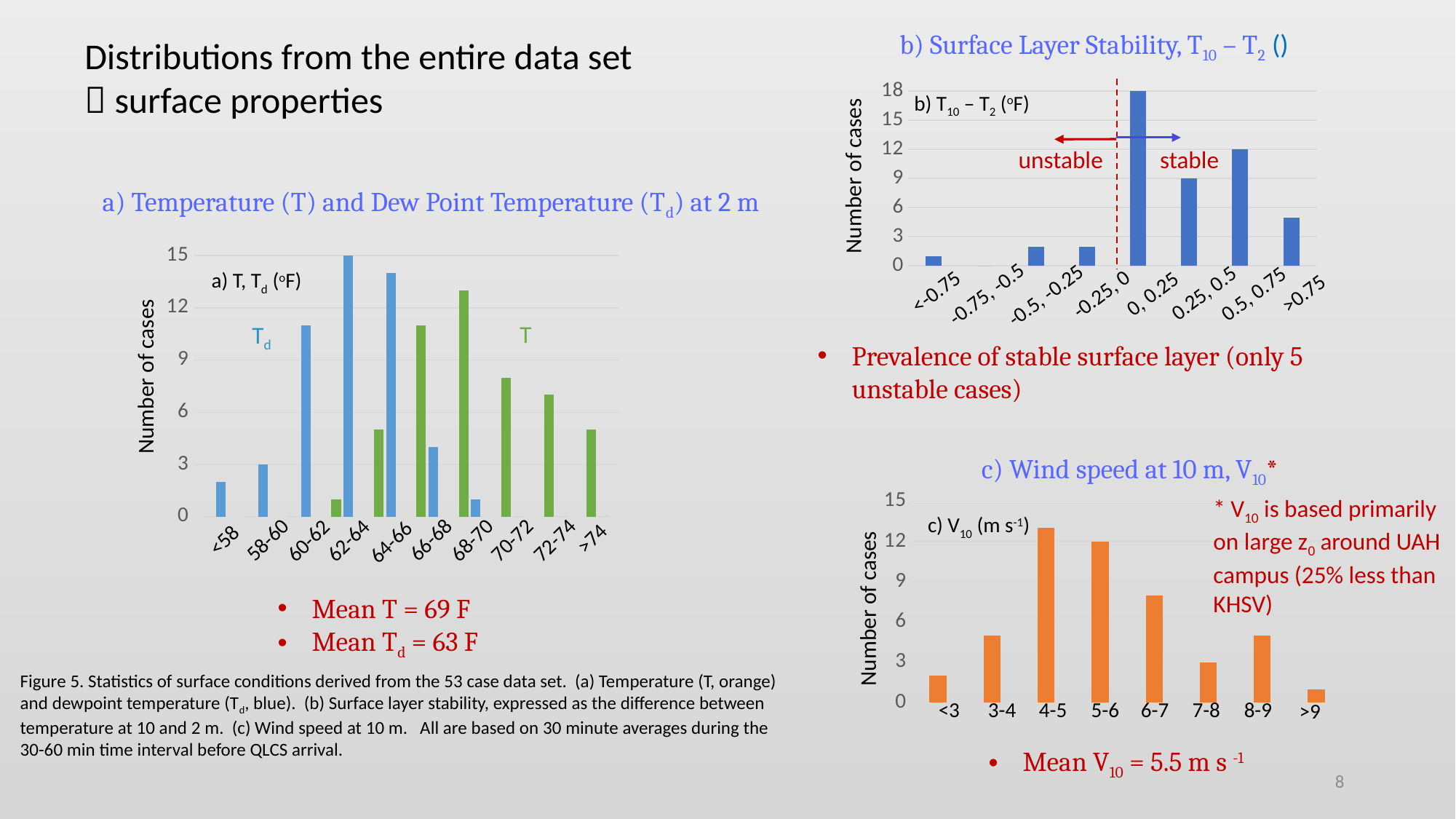
In the chart 'a) Temperature (T) and Dew Point Temperature (Td) at 2 m', is the Td value for the 60-62 bin greater or less than 9? greater In the chart 'c) Wind speed at 10 m, V10', which bin has more cases, 3-4 or 6-7? 6-7 What type of chart is 'c) Wind speed at 10 m, V10'? bar chart In the chart 'a) Temperature (T) and Dew Point Temperature (Td) at 2 m', what is the number of cases for Td in the 62-64 bin? 15 In the chart 'b) Surface Layer Stability, T10 - T2', what is the number of cases for the '0.5, 0.75' bin? 12 How many temperature bins are shown on the x axis of the chart 'a) Temperature (T) and Dew Point Temperature (Td) at 2 m'? 10 In the chart 'a) Temperature (T) and Dew Point Temperature (Td) at 2 m', which bin has the highest number of cases for T? 68-70 In the chart 'b) Surface Layer Stability, T10 - T2', what is the difference in number of cases between the '0, 0.25' bin and the '0.25, 0.5' bin? 9 In the chart 'c) Wind speed at 10 m, V10', what is the number of cases for the 5-6 bin? 12 In the chart 'b) Surface Layer Stability, T10 - T2', which bin has the highest number of cases? 0, 0.25 In the chart 'b) Surface Layer Stability, T10 - T2', what is the number of cases for the '0, 0.25' bin? 18 In the chart 'c) Wind speed at 10 m, V10', which bin has the lowest number of cases? >9